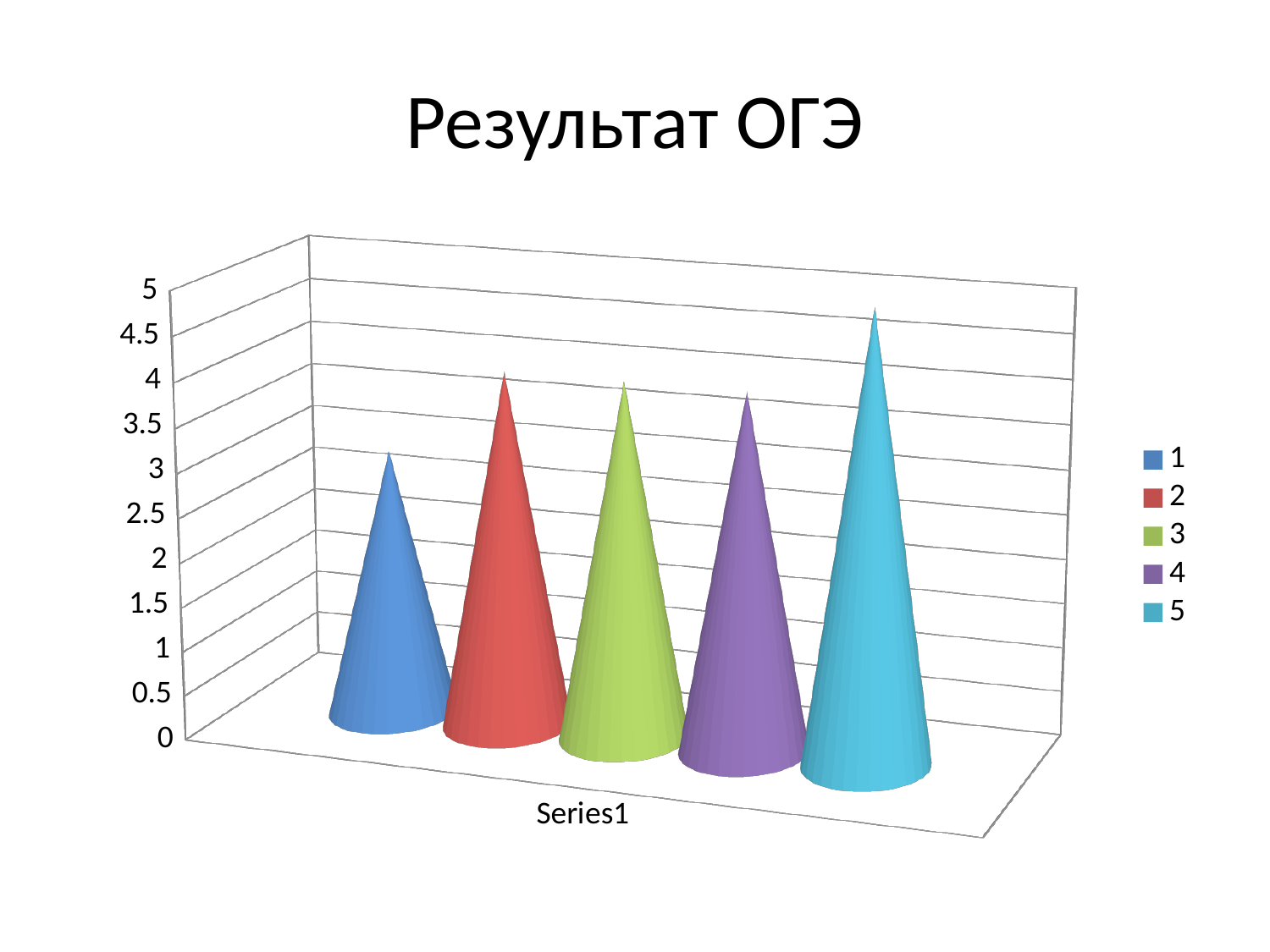
What is the title of the chart? Результат ОГЭ Which is larger, the value for series 2 or the value for series 1? 2 How many series does the legend list? 5 What label is shown on the category axis below the bars? Series1 Which is larger, the value for series 5 or the value for series 1? 5 How many bars are plotted in the chart? 5 What kind of chart is shown on the slide? bar chart Which series has the highest value? 5 Is the value for series 5 greater or less than 4? greater Which series has the lowest value? 1 Is the value for series 1 greater or less than 4? less Is the value for series 1 greater or less than 2? greater